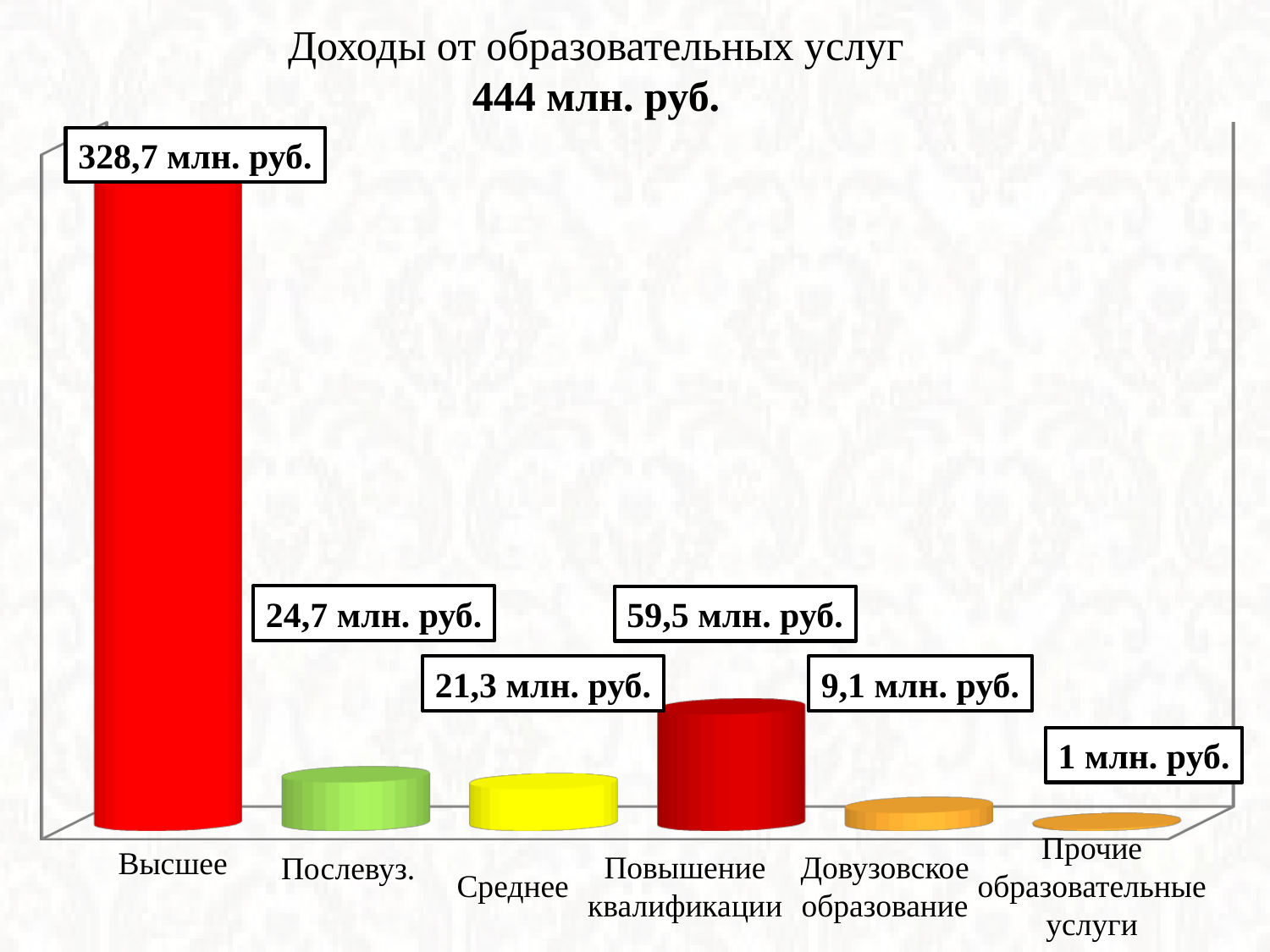
What kind of chart is shown on the slide? Bar chart What is the difference between the values for Высшее and Повышение квалификации? 269,2 млн. руб. What is the value for Довузовское образование? 9,1 млн. руб. What is the difference between the values for Послевуз. and Среднее? 3,4 млн. руб. Which is larger, the value for Послевуз. or the value for Среднее? Послевуз. Which category has the lowest value? Прочие образовательные услуги How many categories are shown in the chart? 6 What is the value for Прочие образовательные услуги? 1 млн. руб. What is the value for Высшее? 328,7 млн. руб. Which category has the highest value? Высшее What total amount is stated in the chart title? 444 млн. руб. What is the value for Повышение квалификации? 59,5 млн. руб.